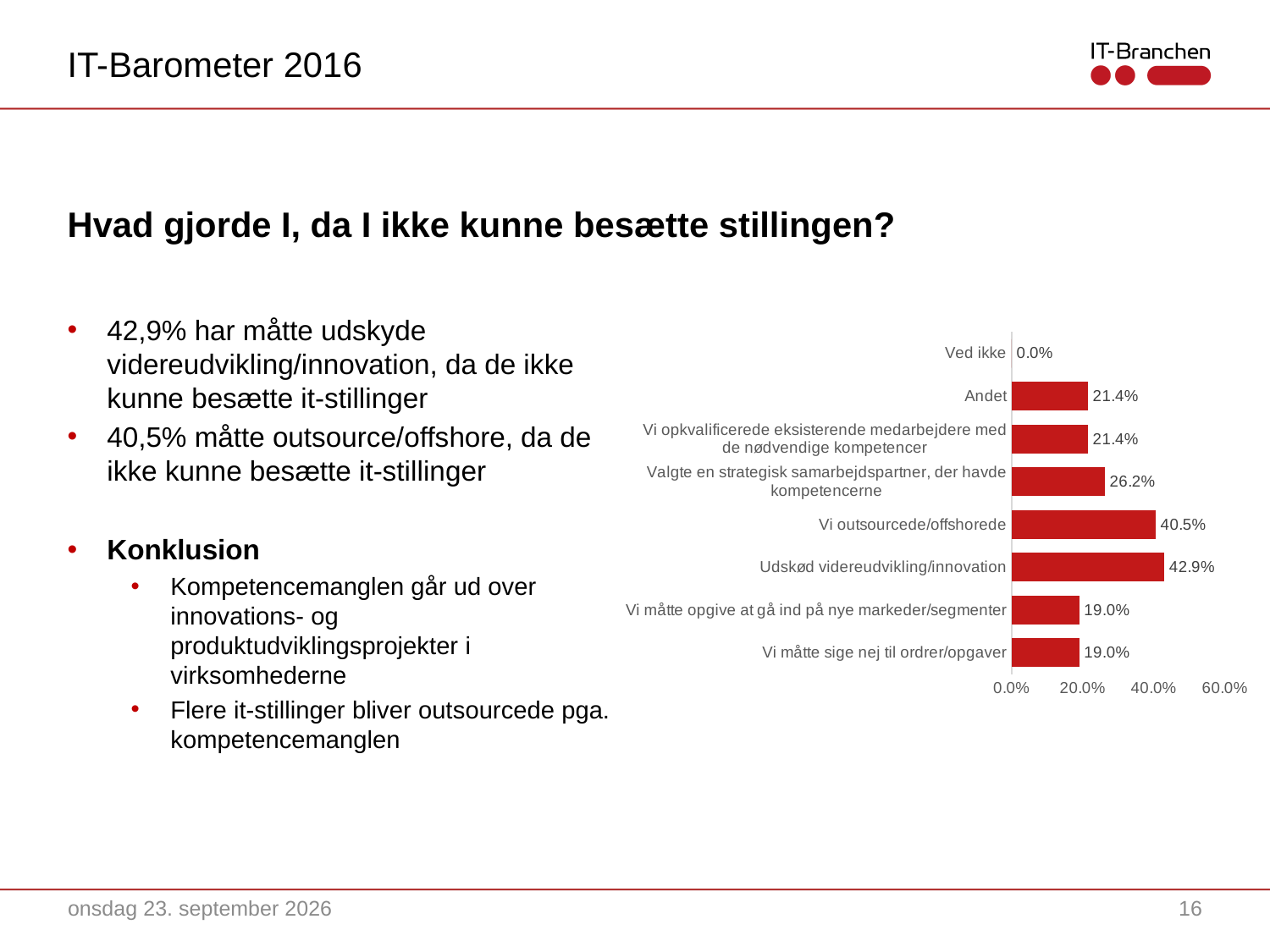
What is the value for "Udskød videreudvikling/innovation"? 42.9% How many categories does the bar chart show? 8 What is the value for "Ved ikke"? 0.0% What is the value for "Vi outsourcede/offshorede"? 40.5% What is the value for "Vi måtte sige nej til ordrer/opgaver"? 19.0% What is the value for "Valgte en strategisk samarbejdspartner, der havde kompetencerne"? 26.2% What is the highest value shown on the chart's horizontal axis? 60.0% Which is larger: the value for "Valgte en strategisk samarbejdspartner, der havde kompetencerne" or the value for "Andet"? Valgte en strategisk samarbejdspartner, der havde kompetencerne What is the difference between the values for "Udskød videreudvikling/innovation" and "Vi outsourcede/offshorede"? 2.4 percentage points What kind of chart is shown on the slide? Bar chart Which category has the highest value in the chart? Udskød videreudvikling/innovation Which category has the lowest value in the chart? Ved ikke